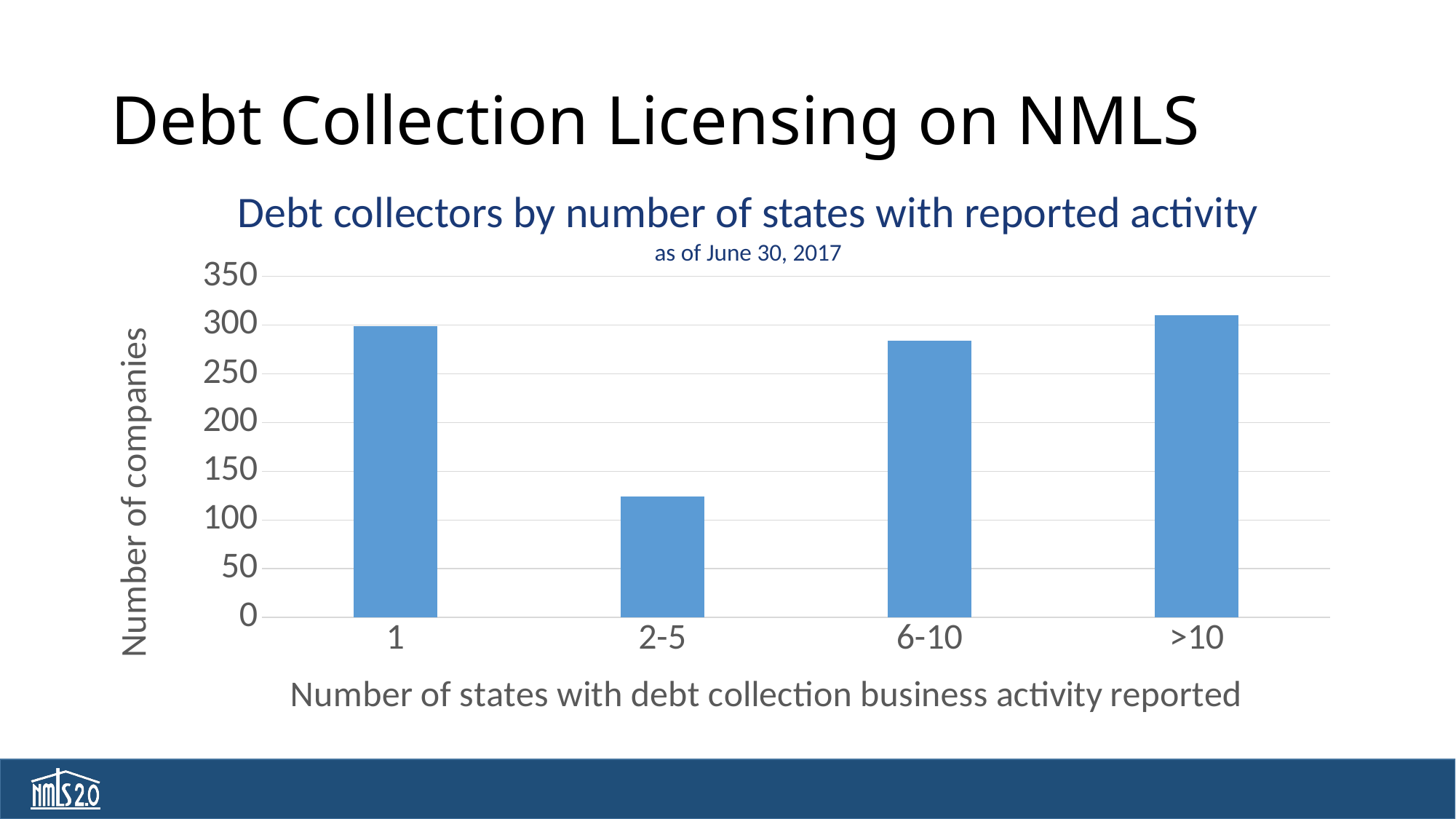
Is the value for the "6-10" category greater or less than 250? greater Is the value for the "2-5" category greater or less than 100? greater How many categories are shown on the x axis of the chart? 4 Is the value for the ">10" category greater or less than 300? greater What is the title of the chart? Debt collectors by number of states with reported activity What is the label of the y axis of the chart? Number of companies Which has more companies, the "1" category or the "2-5" category? 1 What kind of chart is shown on the slide? bar chart Which category has the highest number of companies? >10 Do the values rise or fall from the "2-5" category to the ">10" category? rise Which category has the lowest number of companies? 2-5